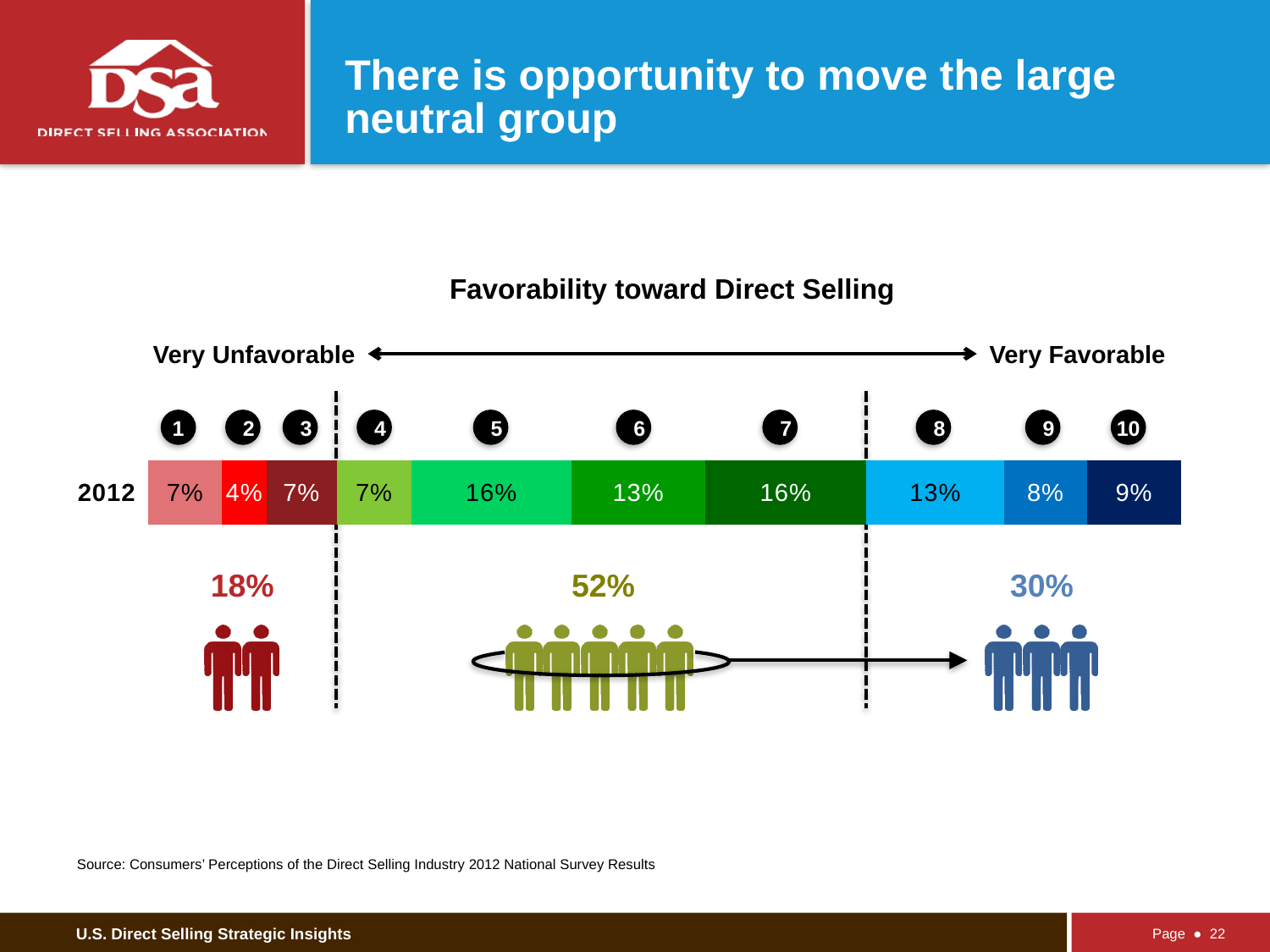
What percentage of respondents gave a rating of 10 in 2012? 9% Which rating has the lowest percentage of respondents in 2012? 2 What percentage of respondents gave a rating of 8 in 2012? 13% What is the combined percentage of the favorable group (ratings 8 through 10)? 30% What is the difference between the percentage for rating 7 and the percentage for rating 9? 8% How many rating categories are shown on the favorability scale? 10 What percentage of respondents gave a rating of 5 on the Favorability toward Direct Selling scale in 2012? 16% What is the combined percentage of the unfavorable group (ratings 1 through 3)? 18% What is the title of the chart? Favorability toward Direct Selling Which has a larger share of respondents, rating 6 or rating 9? Rating 6 What is the combined percentage of the neutral group (ratings 4 through 7)? 52% What percentage of respondents gave a rating of 2 in 2012? 4%